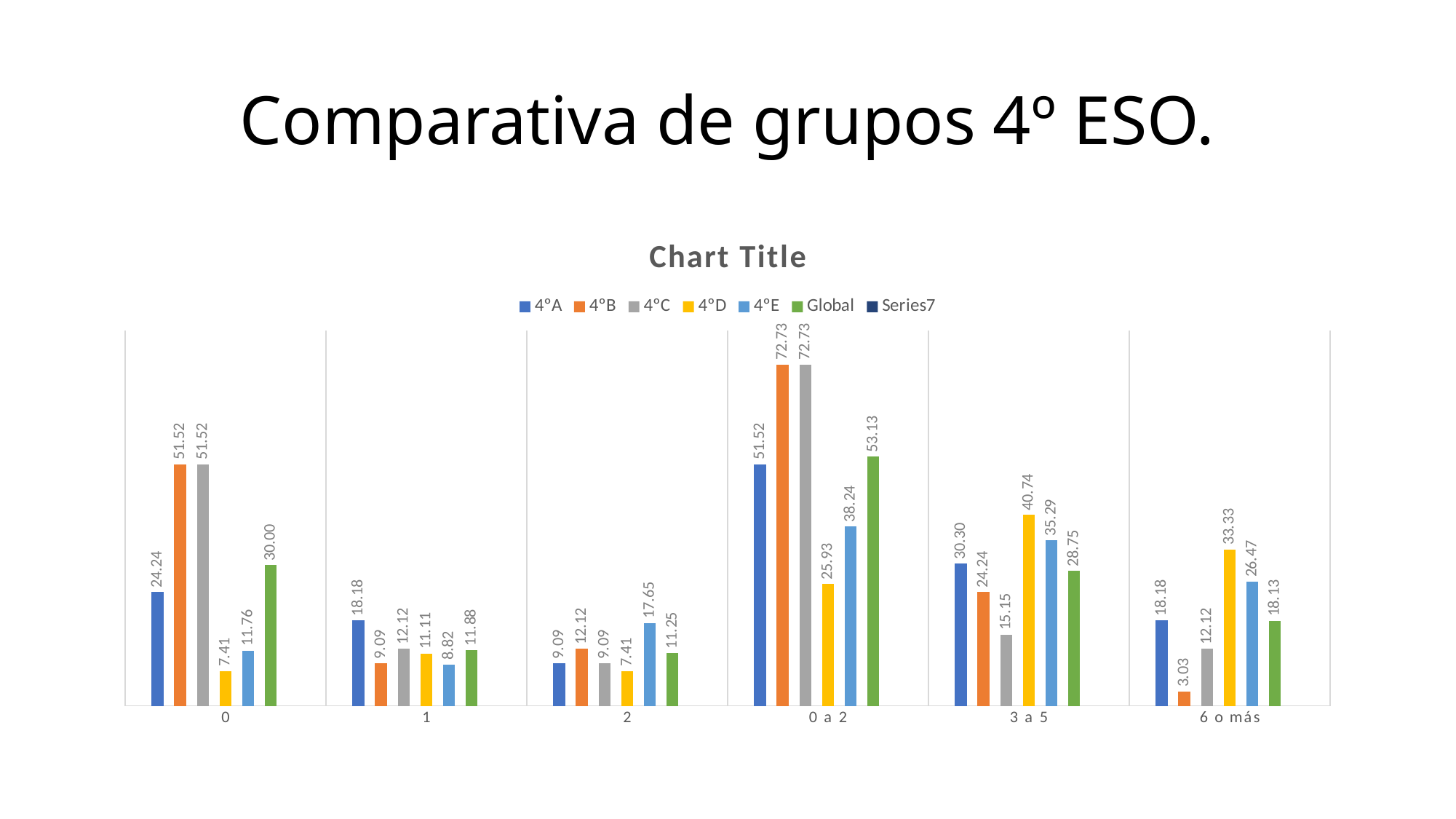
What is the value for 4ºB in the category "6 o más"? 3.03 How many series does the legend list? 7 What is the value for 4ºA in the category "0"? 24.24 Which series has the highest value in the category "3 a 5"? 4ºD How many categories are shown on the x axis? 6 Which series has the lowest value in the category "6 o más"? 4ºB What is the Global value for the category "0 a 2"? 53.13 What is the value for 4ºD in the category "3 a 5"? 40.74 What is the title shown on the chart? Chart Title What type of chart is shown on the slide? bar chart In the category "2", which is larger: the value for 4ºE or the value for Global? 4ºE What is the difference between the 4ºB and 4ºA values in the category "0"? 27.28